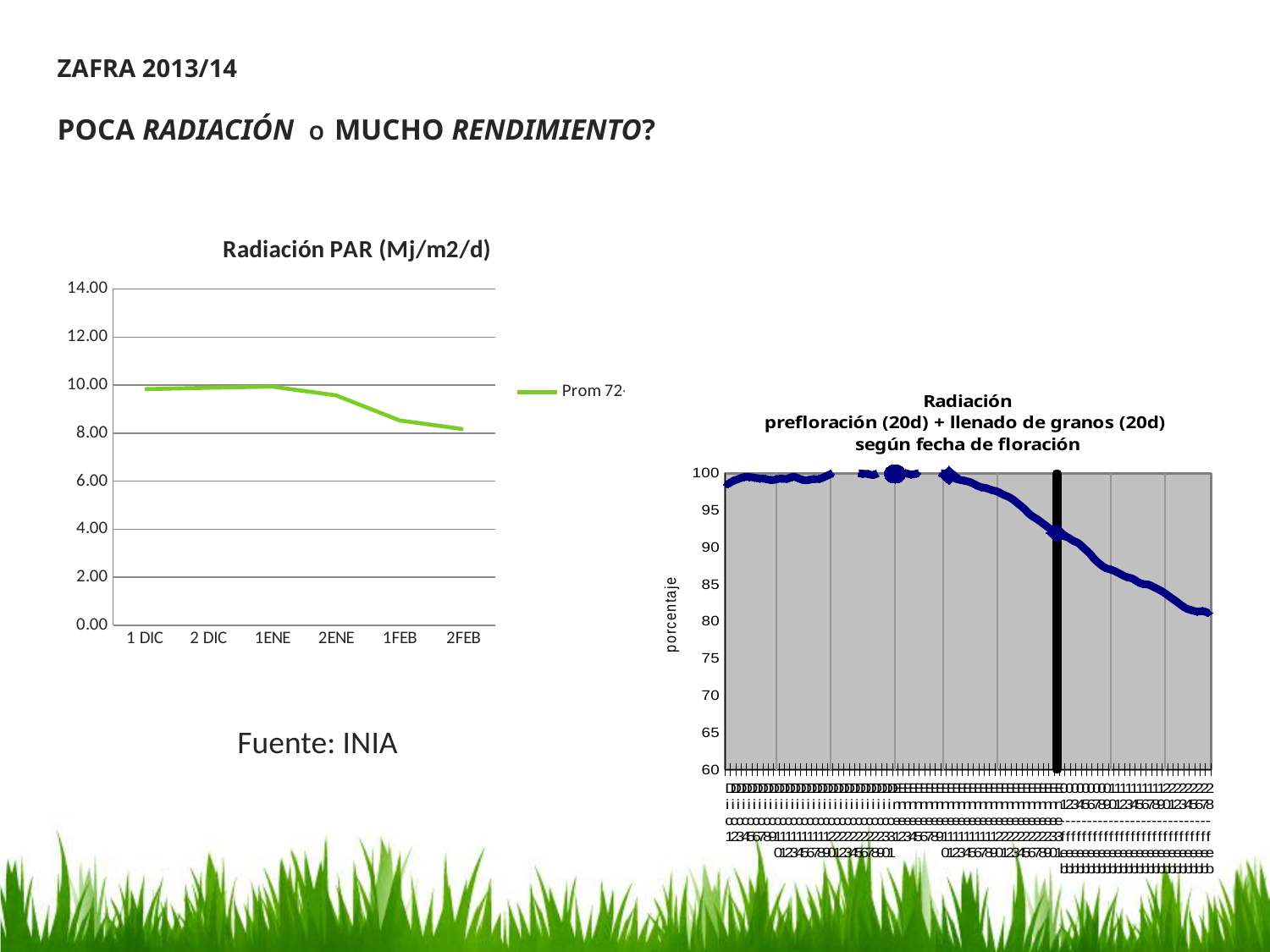
In the 'Radiación PAR (Mj/m2/d)' chart, is the value for 1FEB greater or less than 10.00? less How many categories are shown on the x axis of the 'Radiación PAR (Mj/m2/d)' chart? 6 What is the y-axis label of the chart on the right of the slide? porcentaje In the 'Radiación PAR (Mj/m2/d)' chart, is the value for 1 DIC greater or less than 8.00? greater In the 'Radiación PAR (Mj/m2/d)' chart, do the values generally rise or fall from 1 DIC to 2FEB? fall In the 'Radiación PAR (Mj/m2/d)' chart, which is larger, the value for 1 DIC or the value for 2FEB? 1 DIC How many series does the legend of the 'Radiación PAR (Mj/m2/d)' chart list? 1 In the 'Radiación PAR (Mj/m2/d)' chart, is the value for 1ENE greater or less than 12.00? less What kind of chart is the 'Radiación PAR (Mj/m2/d)' chart on the left? line chart In the chart on the right ('Radiación prefloración (20d) + llenado de granos (20d) según fecha de floración'), do the values rise or fall along the x axis? fall What is the title of the chart on the left of the slide? Radiación PAR (Mj/m2/d)